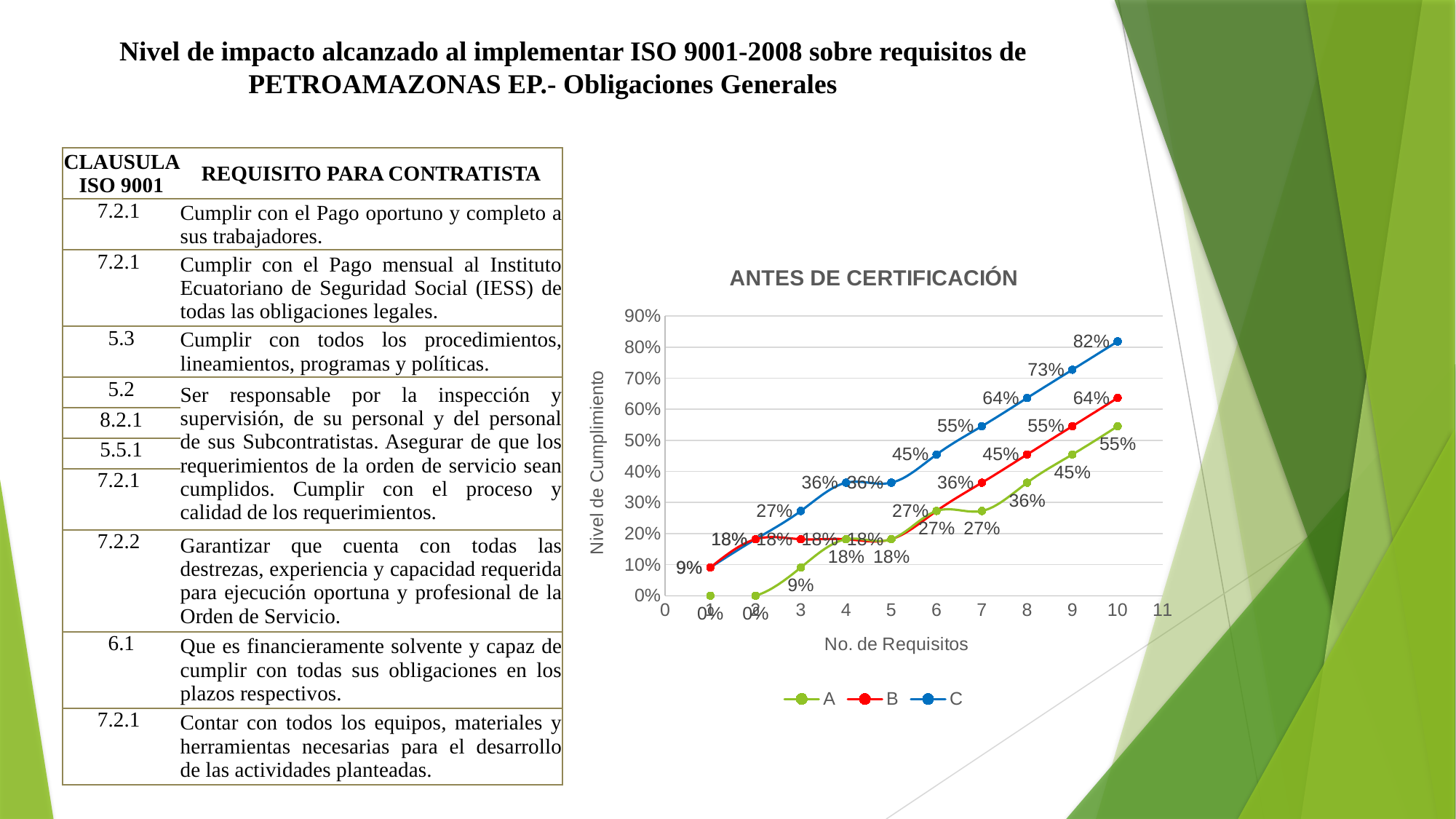
What is the value of series C at requisito 9 in the ANTES DE CERTIFICACIÓN chart? 73% Which series reaches the highest value in the ANTES DE CERTIFICACIÓN chart? C What is the label of the vertical axis in the ANTES DE CERTIFICACIÓN chart? Nivel de Cumplimiento What is the value of series A at requisito 10 in the ANTES DE CERTIFICACIÓN chart? 55% What is the label of the horizontal axis in the ANTES DE CERTIFICACIÓN chart? No. de Requisitos What is the value of series B at requisito 9 in the ANTES DE CERTIFICACIÓN chart? 55% What kind of chart is the ANTES DE CERTIFICACIÓN chart? Line chart What is the value of series C at requisito 10 in the ANTES DE CERTIFICACIÓN chart? 82% In the ANTES DE CERTIFICACIÓN chart, do the values of series C rise or fall as the number of requisitos increases? Rise In the ANTES DE CERTIFICACIÓN chart, what is the difference between series C and series A at requisito 10? 27% How many series does the legend of the ANTES DE CERTIFICACIÓN chart list? 3 In the ANTES DE CERTIFICACIÓN chart, which series has the higher value at requisito 10, B or C? C